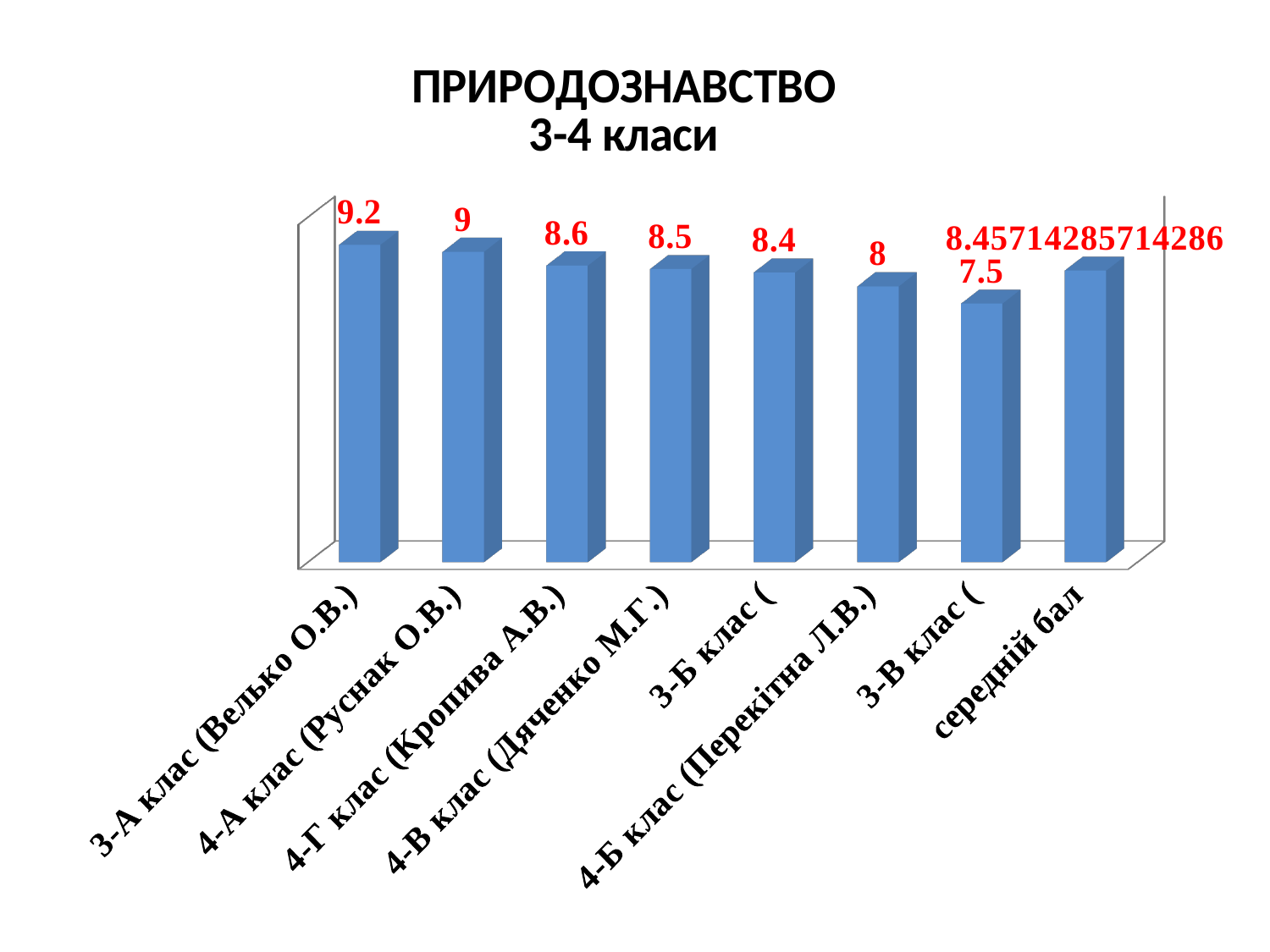
What is the difference between the values for 4-А клас (Руснак О.В.) and 4-Б клас (Перекітна Л.В.)? 1 How many bars are plotted in the chart? 8 What is the value shown for середній бал? 8.45714285714286 What is the value for 4-Г клас (Кропива А.В.)? 8.6 What is the difference between the values for 3-А клас (Велько О.В.) and 3-В клас? 1.7 What is the value for 4-Б клас (Перекітна Л.В.)? 8 Which category has the lowest value? 3-В клас What is the value for 3-А клас (Велько О.В.)? 9.2 Which category has the highest value? 3-А клас (Велько О.В.) Which is larger, the value for 4-В клас (Дяченко М.Г.) or the value for 3-Б клас? 4-В клас (Дяченко М.Г.) What kind of chart is shown on the slide? bar chart What is the title of the chart? ПРИРОДОЗНАВСТВО 3-4 класи